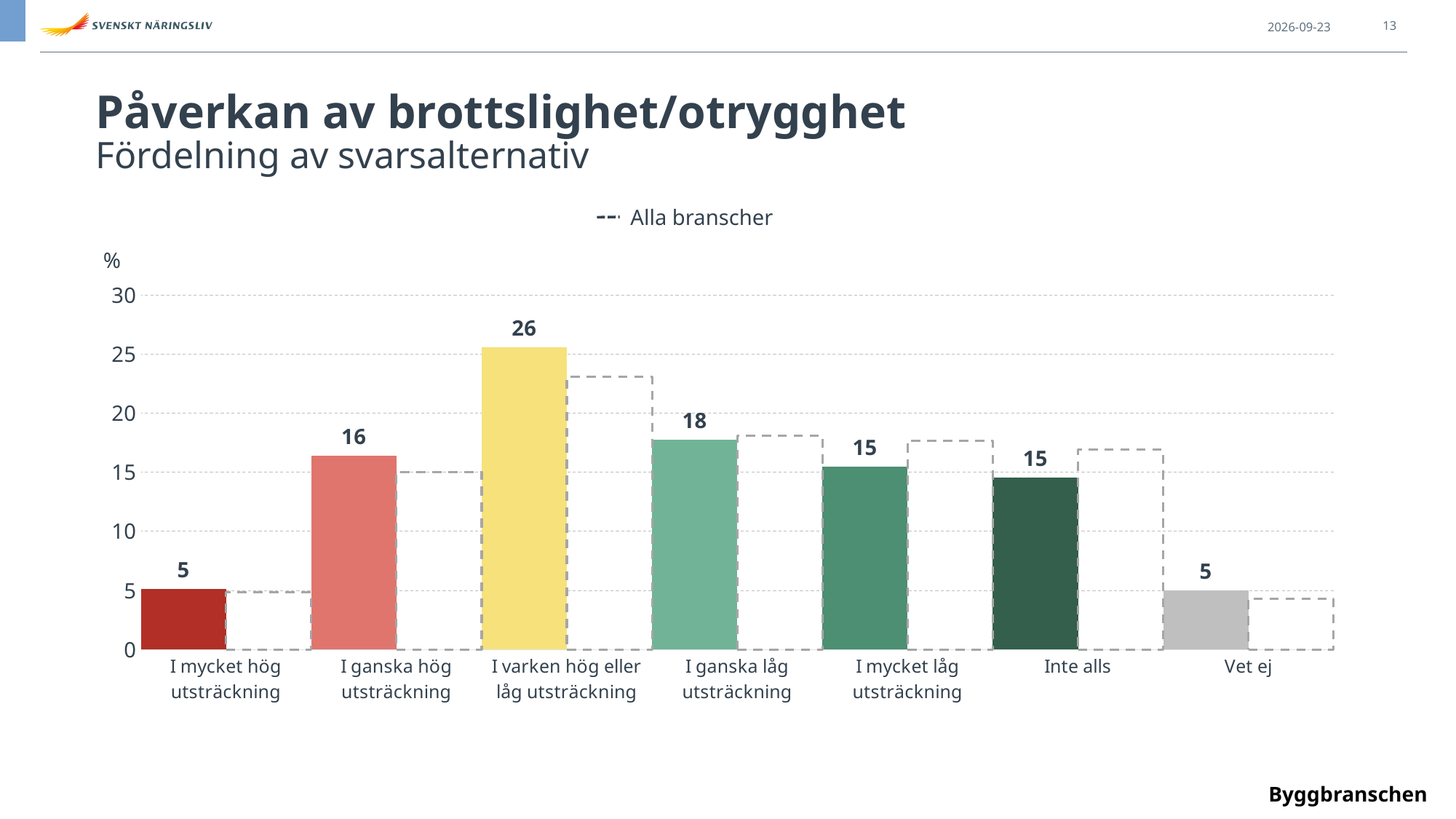
What is the value for "Vet ej"? 5 Which category has the highest value? I varken hög eller låg utsträckning What entry does the legend list? Alla branscher What kind of chart is shown on the slide? bar chart Which is larger, the value for "I ganska hög utsträckning" or "I ganska låg utsträckning"? I ganska låg utsträckning What is the difference between the values for "I varken hög eller låg utsträckning" and "I ganska låg utsträckning"? 8 What unit is shown on the y axis? % What is the value for "I ganska låg utsträckning"? 18 What is the value for "I varken hög eller låg utsträckning"? 26 What is the value for "Inte alls"? 15 Is the dashed "Alla branscher" value for "I varken hög eller låg utsträckning" greater or less than 20? greater How many categories are shown on the x axis? 7